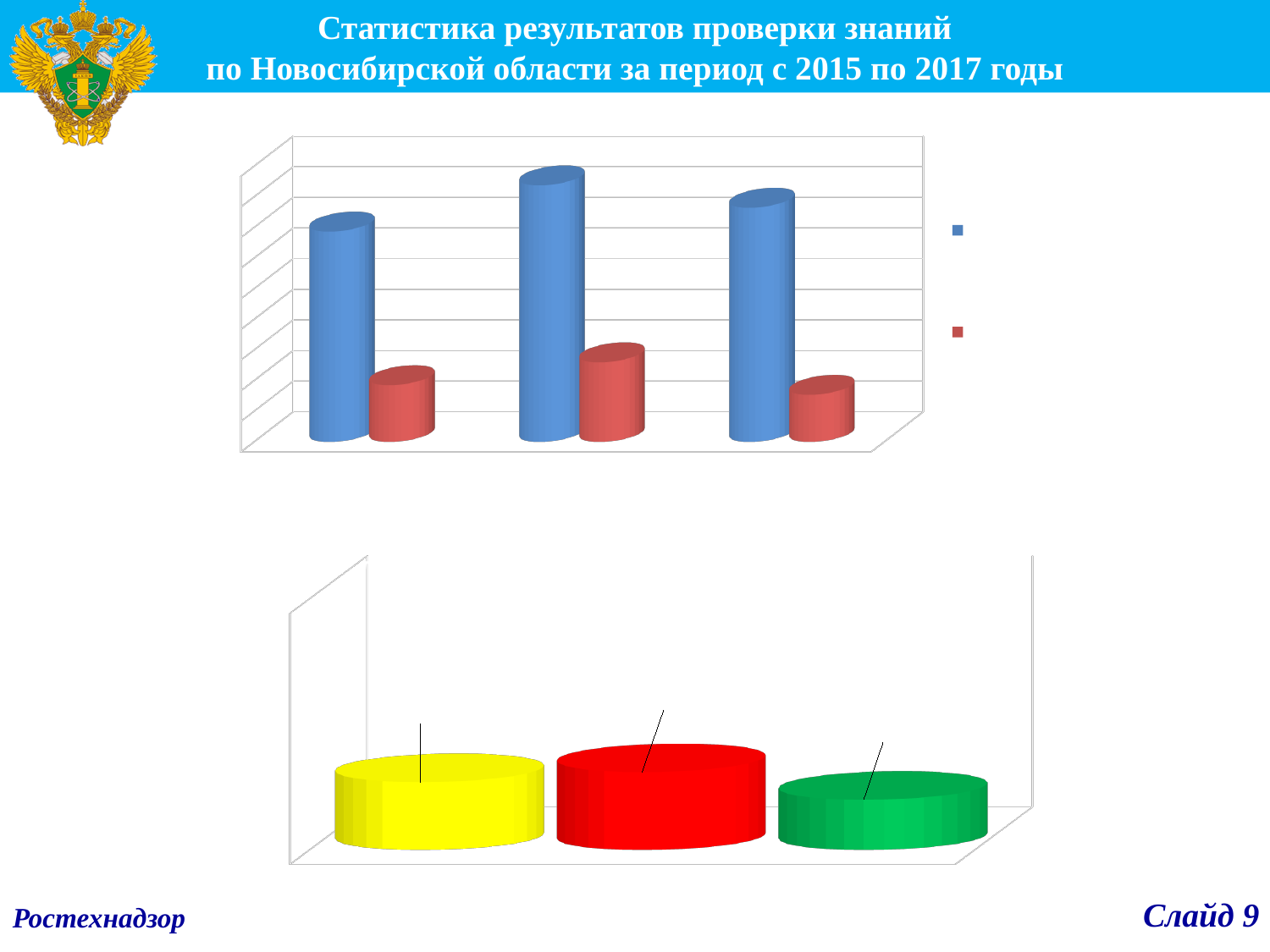
In the top chart, in the first group, which bar is taller, the blue one or the red one? blue What kind of chart is the top chart on the slide? bar chart In the bottom chart, how many bars are plotted? 3 In the top chart, which of the blue bars is the tallest: the first, second or third group? second In the top chart, how many groups of bars are plotted? 3 In the bottom chart, which bar is taller, the yellow one or the red one? red In the top chart, how many series does the legend list? 2 In the top chart, which colour is the first series in the legend? blue In the top chart, in the third group, which bar is taller, the blue one or the red one? blue In the bottom chart, which bar is the tallest: the yellow, red or green one? red In the top chart, which of the red bars is the tallest: the first, second or third group? second What kind of chart is the bottom chart on the slide? bar chart